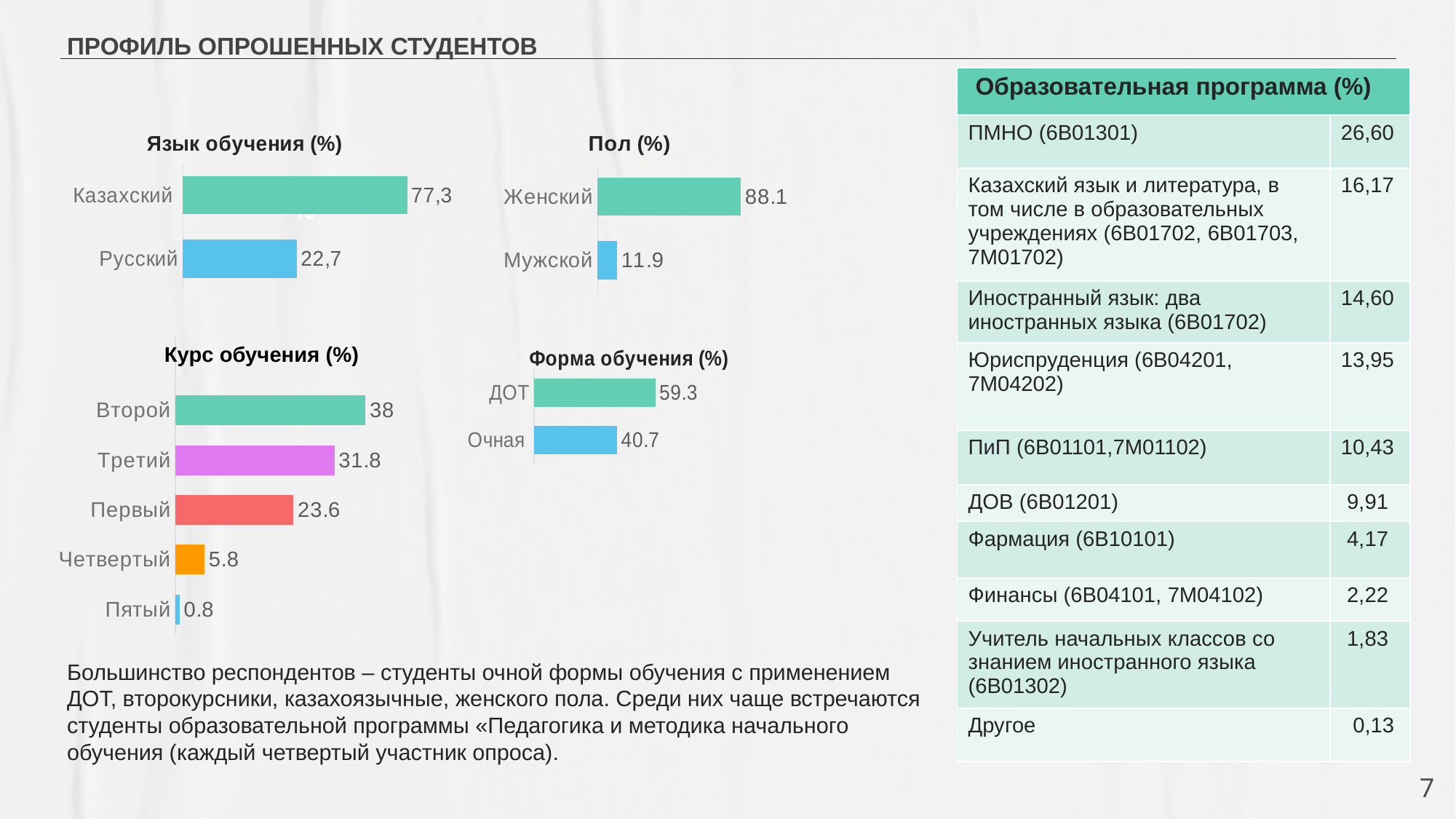
In the chart titled "Курс обучения (%)", which category has the highest value? Второй In the chart titled "Курс обучения (%)", which category has the lowest value? Пятый In the chart titled "Курс обучения (%)", how many categories are shown? 5 In the chart titled "Курс обучения (%)", what is the difference between the values for Второй and Третий? 6.2 What type of chart is the one titled "Пол (%)"? Bar chart In the chart titled "Пол (%)", what is the value for Мужской? 11.9 In the chart titled "Пол (%)", what is the difference between the values for Женский and Мужской? 76.2 In the chart titled "Курс обучения (%)", what is the value for Первый? 23.6 In the chart titled "Форма обучения (%)", what is the value for Очная? 40.7 In the chart titled "Форма обучения (%)", which is larger, ДОТ or Очная? ДОТ In the chart titled "Язык обучения (%)", what is the value for Русский? 22,7 In the chart titled "Язык обучения (%)", what is the value for Казахский? 77,3